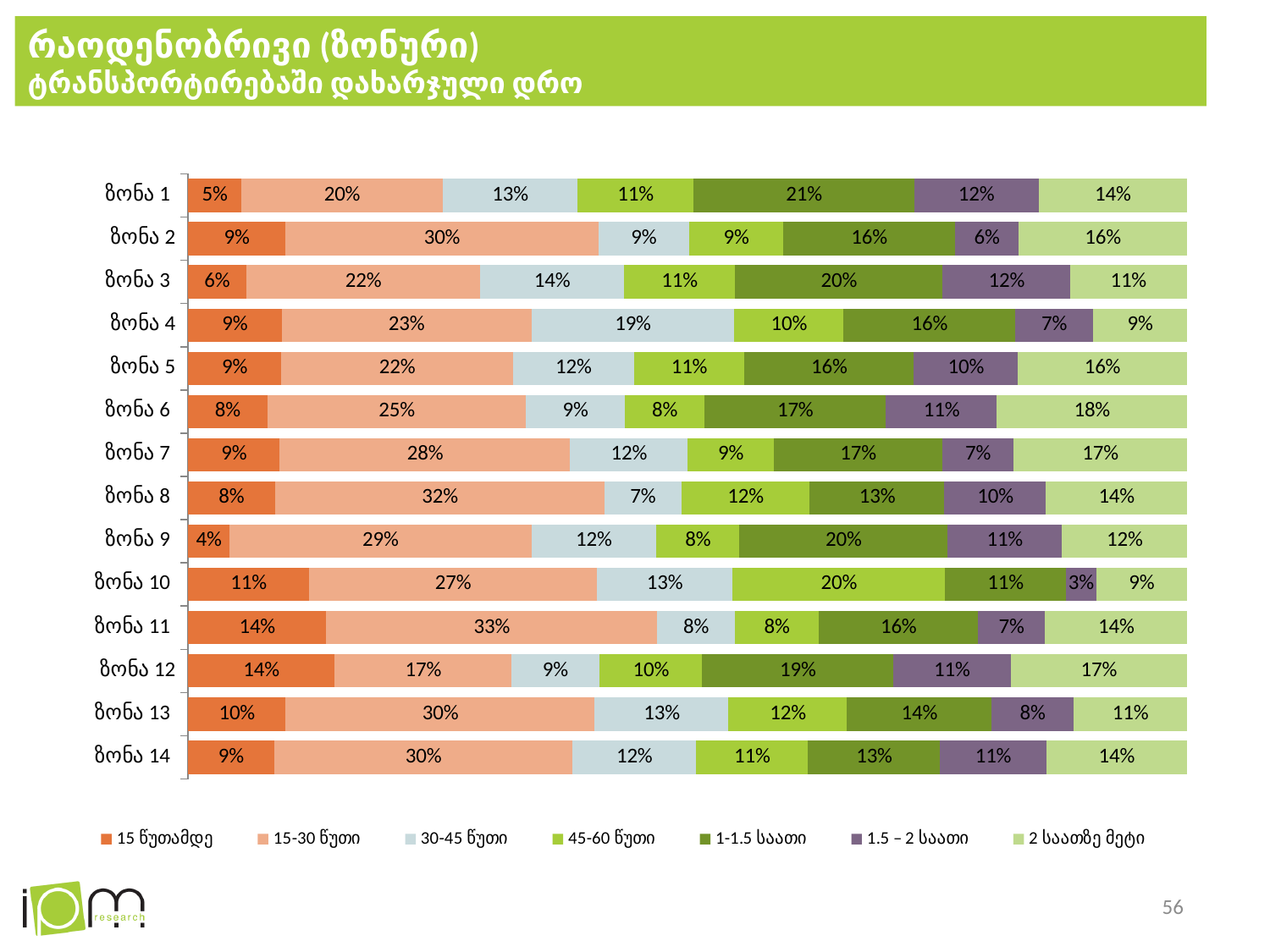
Which is larger: the 15-30 წუთი value for ზონა 8 or for ზონა 12? ზონა 8 What kind of chart is shown on the slide? Stacked bar chart What is the value for 1-1.5 საათი in ზონა 1? 21% Which zone has the lowest value for 1.5 – 2 საათი? ზონა 10 How many series does the legend list? 7 What is the value for 2 საათზე მეტი in ზონა 6? 18% What is the value for 1.5 – 2 საათი in ზონა 10? 3% Which zone has the lowest value for 15 წუთამდე? ზონა 9 What is the value for 15-30 წუთი in ზონა 11? 33% How many zones are shown on the chart? 14 Which zone has the highest value for 15-30 წუთი? ზონა 11 What is the difference between the 1-1.5 საათი values for ზონა 1 and ზონა 2? 5 percentage points